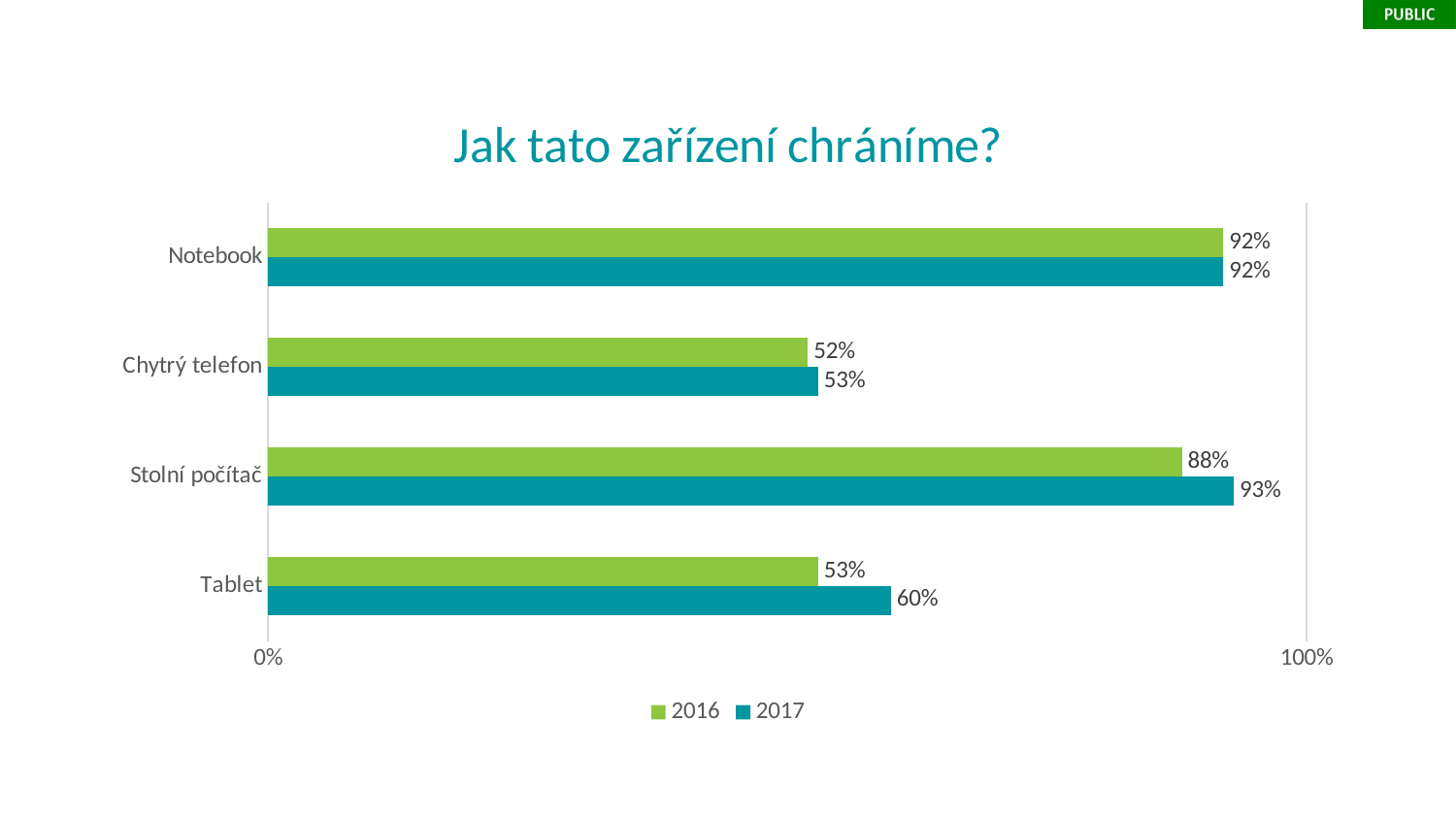
What kind of chart is shown on the slide? Bar chart What is the difference between the 2017 and 2016 values for Stolní počítač? 5% How many categories are shown on the chart? 4 How many series does the legend list? 2 Which category has the lowest value in 2016? Chytrý telefon What is the value for Chytrý telefon in 2016? 52% What is the value for Stolní počítač in 2017? 93% Which category has the highest value in 2017? Stolní počítač Which is larger: the 2017 value for Tablet or the 2017 value for Chytrý telefon? Tablet What is the value for Notebook in 2017? 92% What is the value for Tablet in 2016? 53% What is the difference between the 2017 and 2016 values for Tablet? 7%